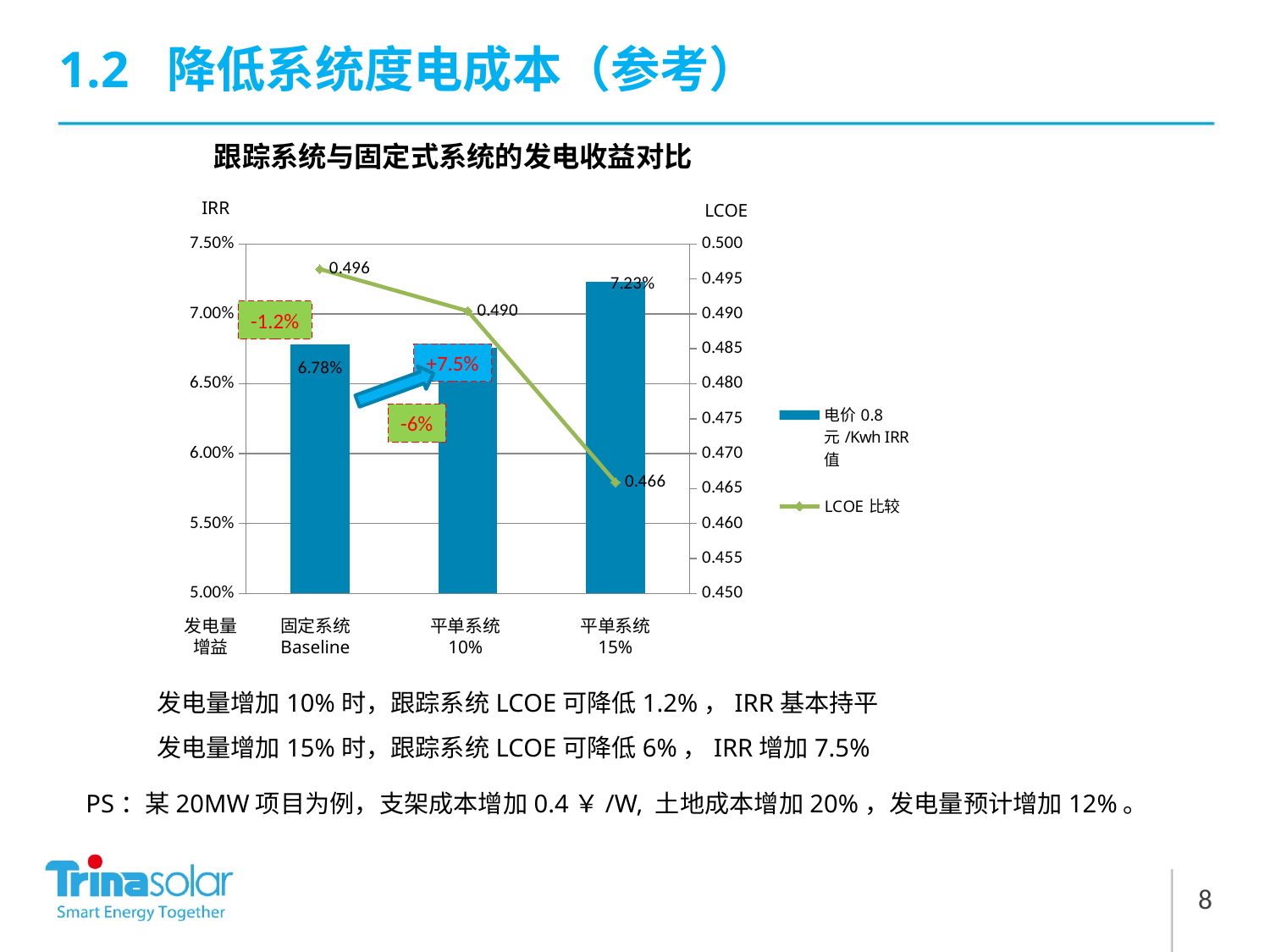
What is the LCOE value shown for 平单系统 15%? 0.466 Does the LCOE line rise or fall from 固定系统 Baseline to 平单系统 15%? fall What is the LCOE value shown for 平单系统 10%? 0.490 Which category has the lowest LCOE value? 平单系统 15% What is the IRR value shown for 平单系统 15%? 7.23% Which category has the highest IRR bar? 平单系统 15% What is the difference between the LCOE of 固定系统 Baseline and 平单系统 15%? 0.030 What is the LCOE value shown for 固定系统 Baseline? 0.496 What is the IRR value shown for 固定系统 Baseline? 6.78% Is the IRR bar for 平单系统 10% greater or less than 6.50%? greater How many series does the legend list? 2 How many categories are shown on the x axis of the chart? 3